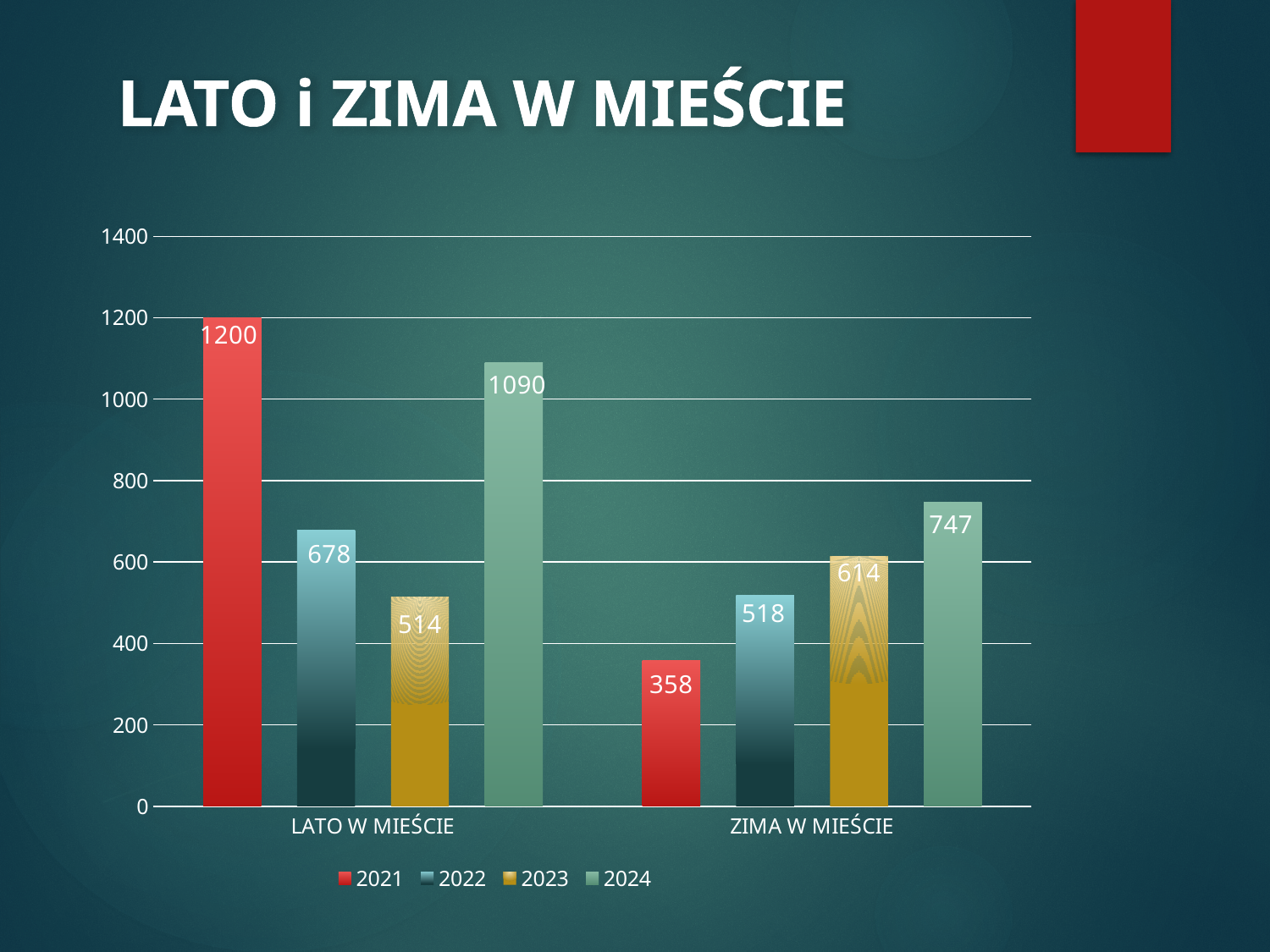
What is the value for 2024 in the ZIMA W MIEŚCIE category? 747 Which is larger: the 2023 value for LATO W MIEŚCIE or the 2023 value for ZIMA W MIEŚCIE? ZIMA W MIEŚCIE What is the value for 2021 in the LATO W MIEŚCIE category? 1200 Which year has the highest value in the LATO W MIEŚCIE category? 2021 What is the value for 2023 in the LATO W MIEŚCIE category? 514 What is the value for 2022 in the ZIMA W MIEŚCIE category? 518 What is the title of the slide? LATO i ZIMA W MIEŚCIE What kind of chart is shown on the slide? bar chart How many series does the legend list? 4 What is the difference between the 2021 values for LATO W MIEŚCIE and ZIMA W MIEŚCIE? 842 How many categories are shown on the x axis? 2 Which year has the lowest value in the ZIMA W MIEŚCIE category? 2021